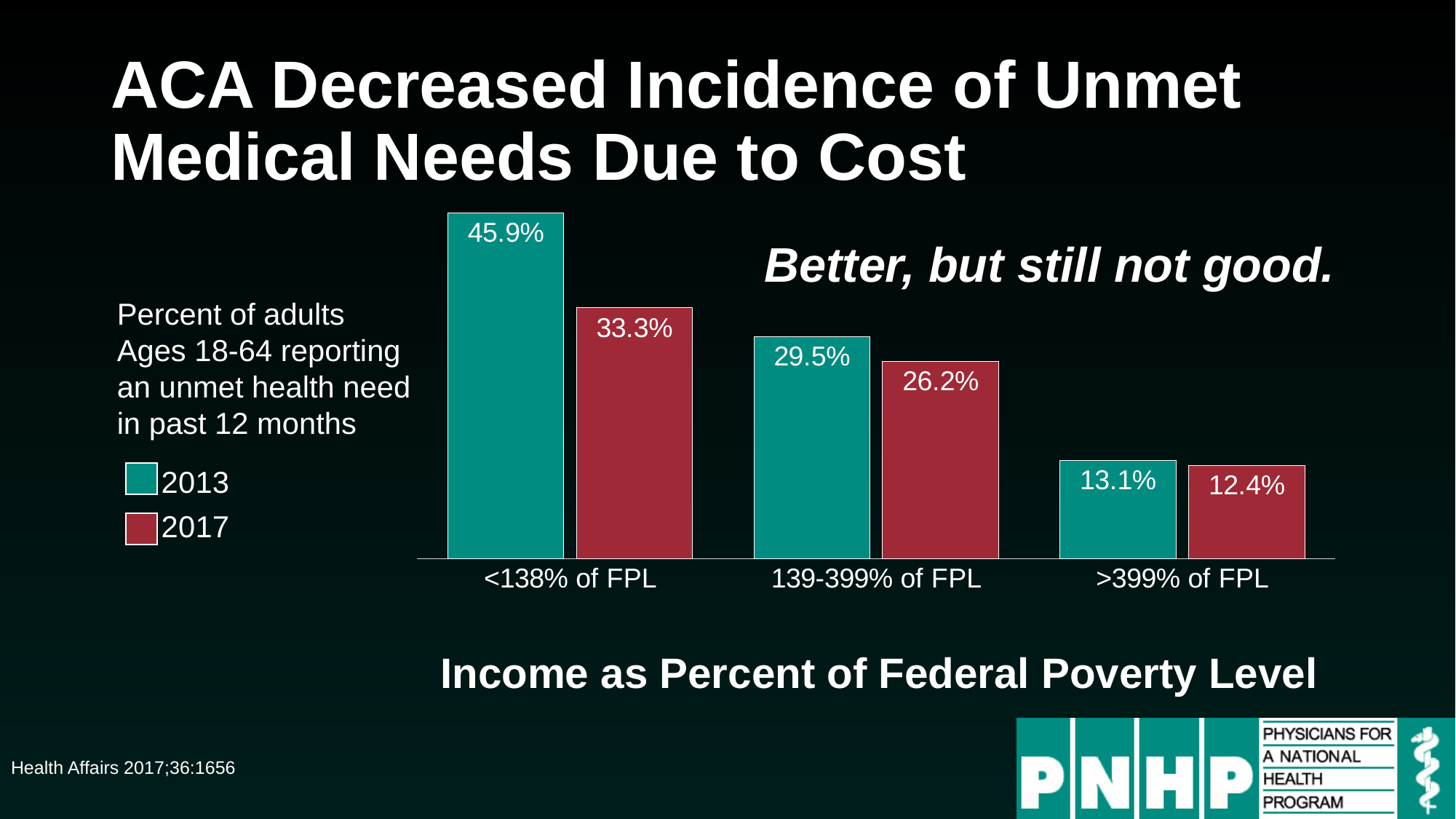
What percent of adults with income <138% of FPL reported an unmet health need in 2013? 45.9% What kind of chart is shown on the slide? Bar chart Which colour represents the 2017 series in the legend? Red Which income group has the highest 2017 value? <138% of FPL What is the 2017 value for the 139-399% of FPL group? 26.2% What is the difference between the 2013 and 2017 values for the 139-399% of FPL group? 3.3 percentage points By how many percentage points did the value for the <138% of FPL group fall from 2013 to 2017? 12.6 percentage points What is the 2013 value for the >399% of FPL group? 13.1% How many income groups are shown on the x axis? 3 Which income group has the lowest 2013 value? >399% of FPL How many series does the legend list? 2 Which is larger: the 2017 value for <138% of FPL or the 2013 value for 139-399% of FPL? 2017 value for <138% of FPL